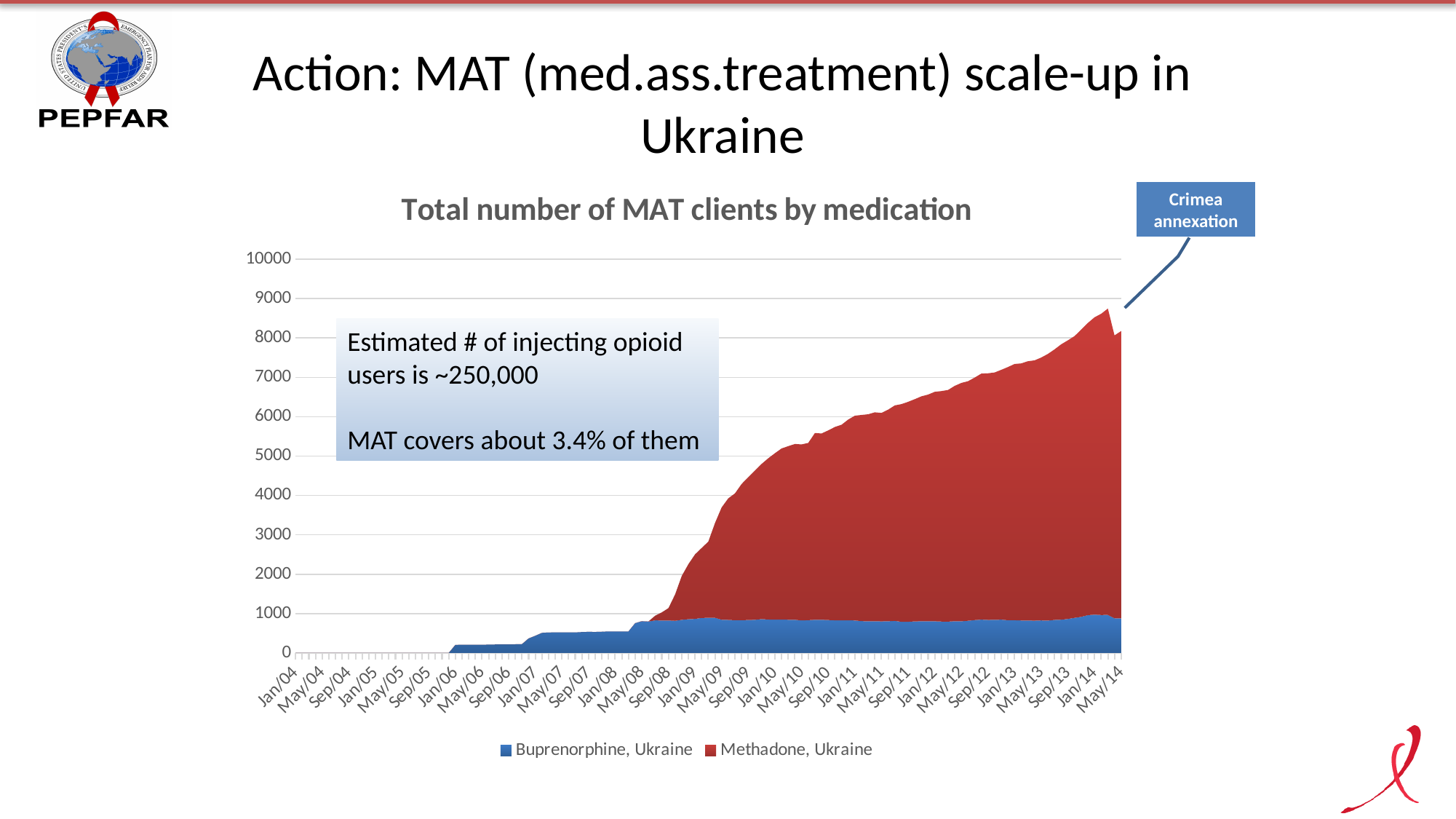
Is the total number of MAT clients in Jan/14 greater or less than 8000? greater Which series has the larger number of clients in Jan/07, Buprenorphine or Methadone? Buprenorphine Is the number of Buprenorphine clients in Jan/10 greater or less than 1000? less Does the total number of MAT clients generally rise or fall from Jan/04 to Jan/14? Rise Is the total number of MAT clients in Jan/13 greater or less than 7000? greater In Jan/12, which series has more clients, Buprenorphine or Methadone? Methadone What kind of chart is shown on the slide? Stacked area chart Which two series are listed in the chart legend? Buprenorphine, Ukraine and Methadone, Ukraine What is the title of the chart? Total number of MAT clients by medication How many series does the chart legend list? 2